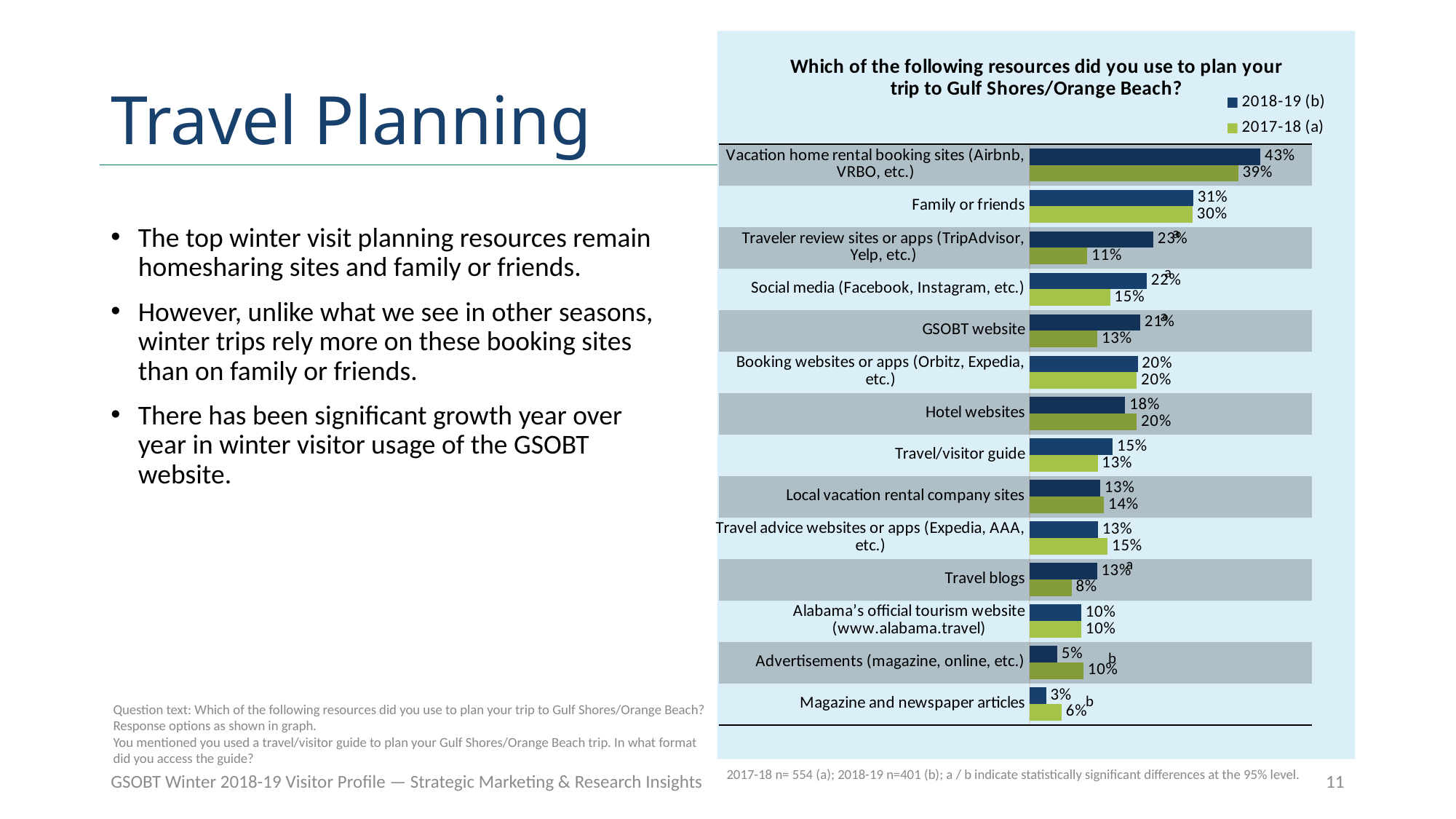
What is the difference between the 2018-19 and 2017-18 values for GSOBT website? 8 percentage points What is the 2017-18 value for Family or friends? 30% What is the 2017-18 value for Traveler review sites or apps (TripAdvisor, Yelp, etc.)? 11% What is the 2018-19 value for Vacation home rental booking sites (Airbnb, VRBO, etc.)? 43% What is the 2017-18 value for Advertisements (magazine, online, etc.)? 10% Which series is shown in dark blue in the chart? 2018-19 (b) How many series does the chart legend list? 2 How many resource categories are shown in the chart? 14 What kind of chart is shown on the slide? bar chart Which category has the lowest 2018-19 value? Magazine and newspaper articles Which category has the highest 2018-19 value? Vacation home rental booking sites (Airbnb, VRBO, etc.) For Hotel websites, which is larger: the 2018-19 value or the 2017-18 value? 2017-18